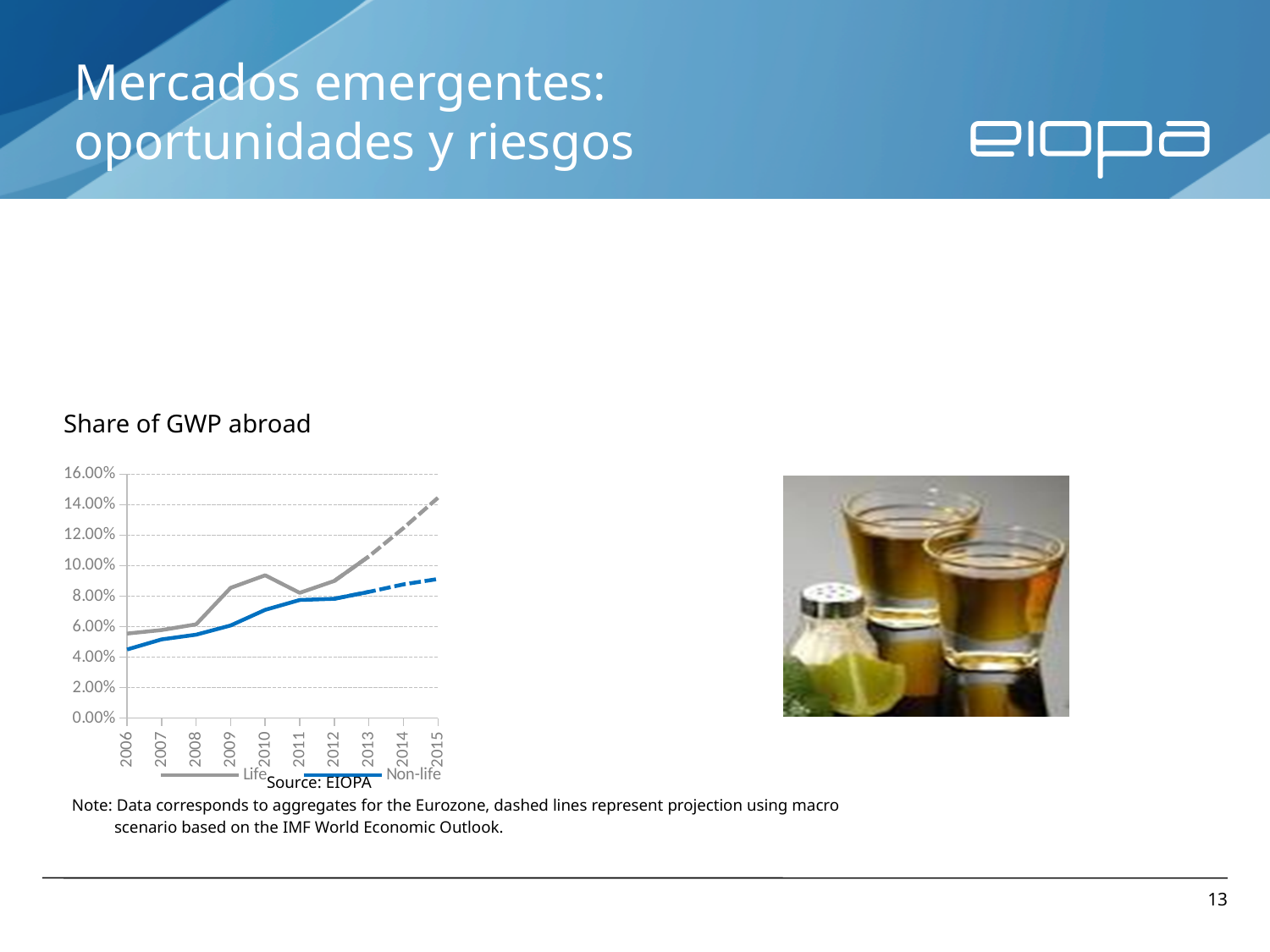
Is the Life value for 2015 greater or less than 12.00%? greater How many years are shown on the x axis of the chart? 10 What is the title of the chart? Share of GWP abroad In which year is the Non-life series at its lowest value? 2006 Is the Non-life value for 2015 greater or less than 10.00%? less How many series does the chart legend list? 2 What kind of chart is shown on the slide? Line chart Is the Life value for 2010 greater or less than 8.00%? greater In which year does the Life series reach its highest value? 2015 Does the Non-life series generally rise or fall from 2006 to 2015? rise Which series has the higher value in 2015, Life or Non-life? Life